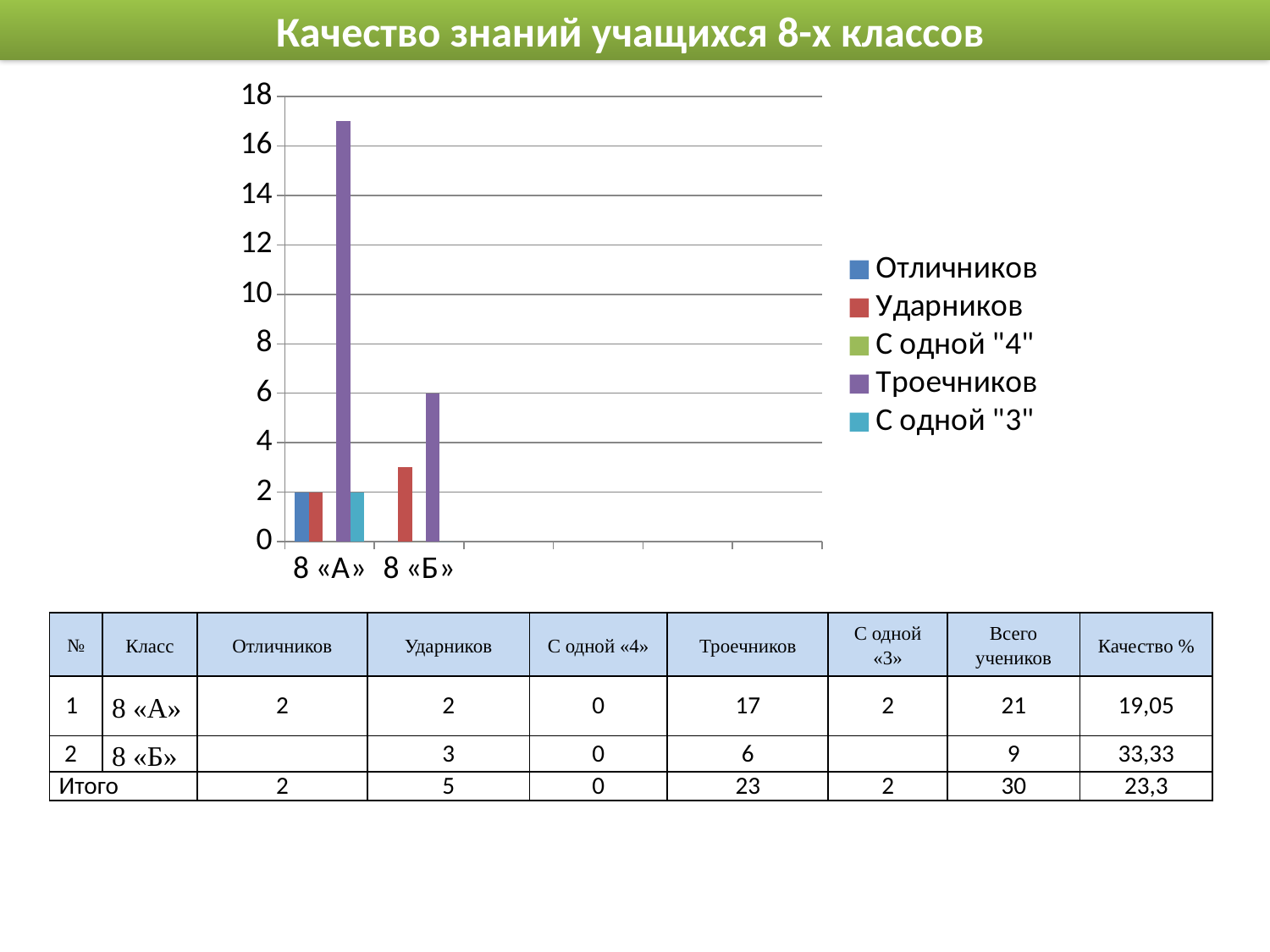
Which class has the larger value for Троечников, 8 «А» or 8 «Б»? 8 «А» What is the value of Троечников for 8 «Б» in the chart? 6 What kind of chart is shown on the slide? bar chart Is the value of Троечников for 8 «А» greater or less than 16? greater What is the title of the slide containing the chart? Качество знаний учащихся 8-х классов Which series has the highest bar in the chart? Троечников How many classes (categories) are shown on the x axis of the chart? 2 What is the value of Отличников for 8 «А» in the chart? 2 Is the value of Ударников for 8 «Б» greater or less than 4? less How many series does the chart legend list? 5 Which class has the larger value for Ударников, 8 «А» or 8 «Б»? 8 «Б» What is the difference between the Троечников values for 8 «А» and 8 «Б»? 11